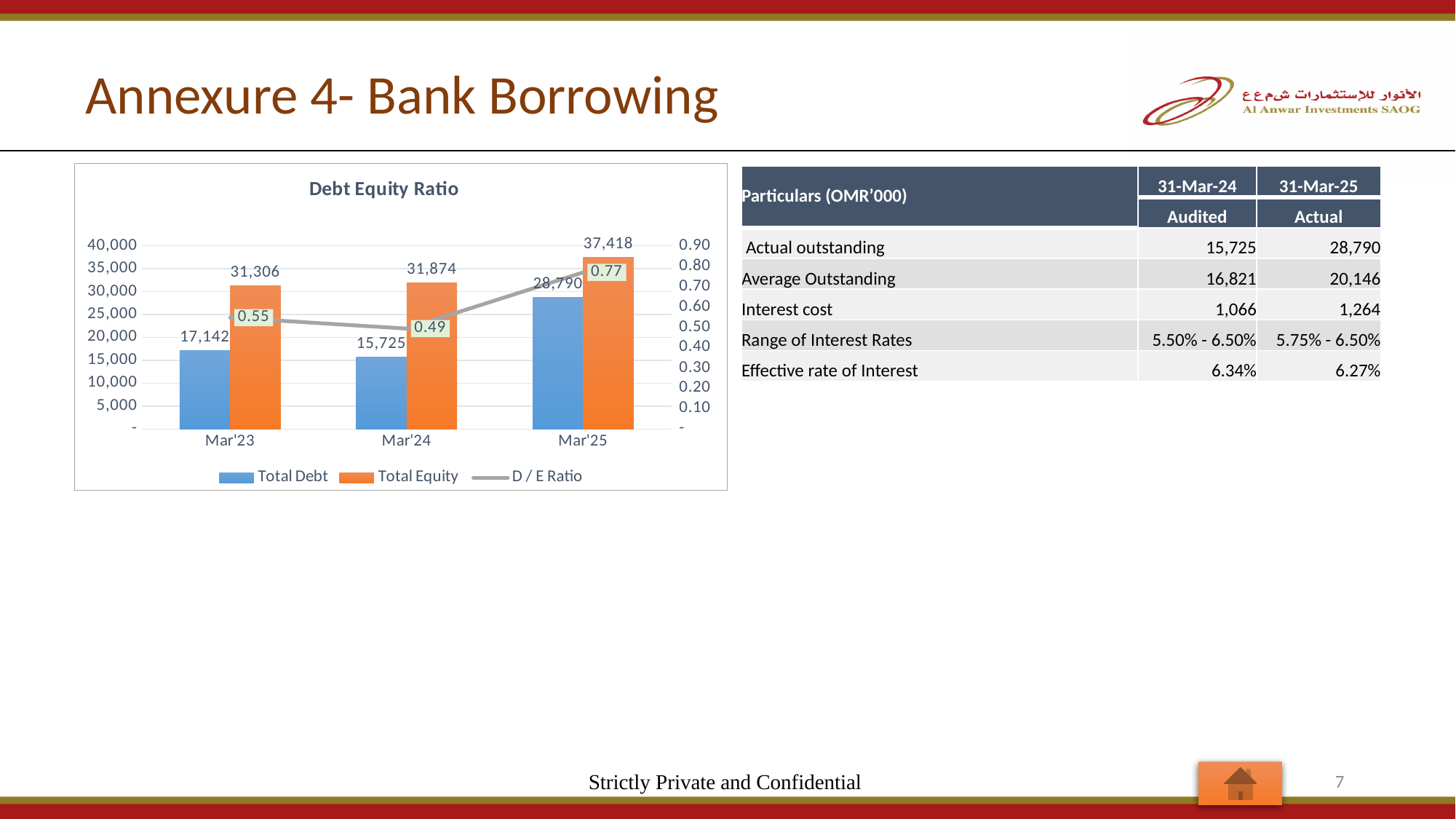
What is the difference between Total Equity and Total Debt for Mar'23 in the Debt Equity Ratio chart? 14,164 Is the Total Equity value for Mar'24 greater or less than 30,000 in the Debt Equity Ratio chart? greater Is Total Debt for Mar'25 larger than Total Debt for Mar'23 in the Debt Equity Ratio chart? Yes Does Total Equity rise or fall from Mar'23 to Mar'25 in the Debt Equity Ratio chart? Rise What is the D / E Ratio for Mar'23 in the Debt Equity Ratio chart? 0.55 What is the Total Debt value for Mar'24 in the Debt Equity Ratio chart? 15,725 What kind of chart is the Debt Equity Ratio chart? Combined bar and line chart Which period has the lowest D / E Ratio in the Debt Equity Ratio chart? Mar'24 How many series does the legend of the Debt Equity Ratio chart list? 3 Which period has the highest Total Debt in the Debt Equity Ratio chart? Mar'25 What is the Total Equity value for Mar'25 in the Debt Equity Ratio chart? 37,418 How many periods are shown on the x axis of the Debt Equity Ratio chart? 3